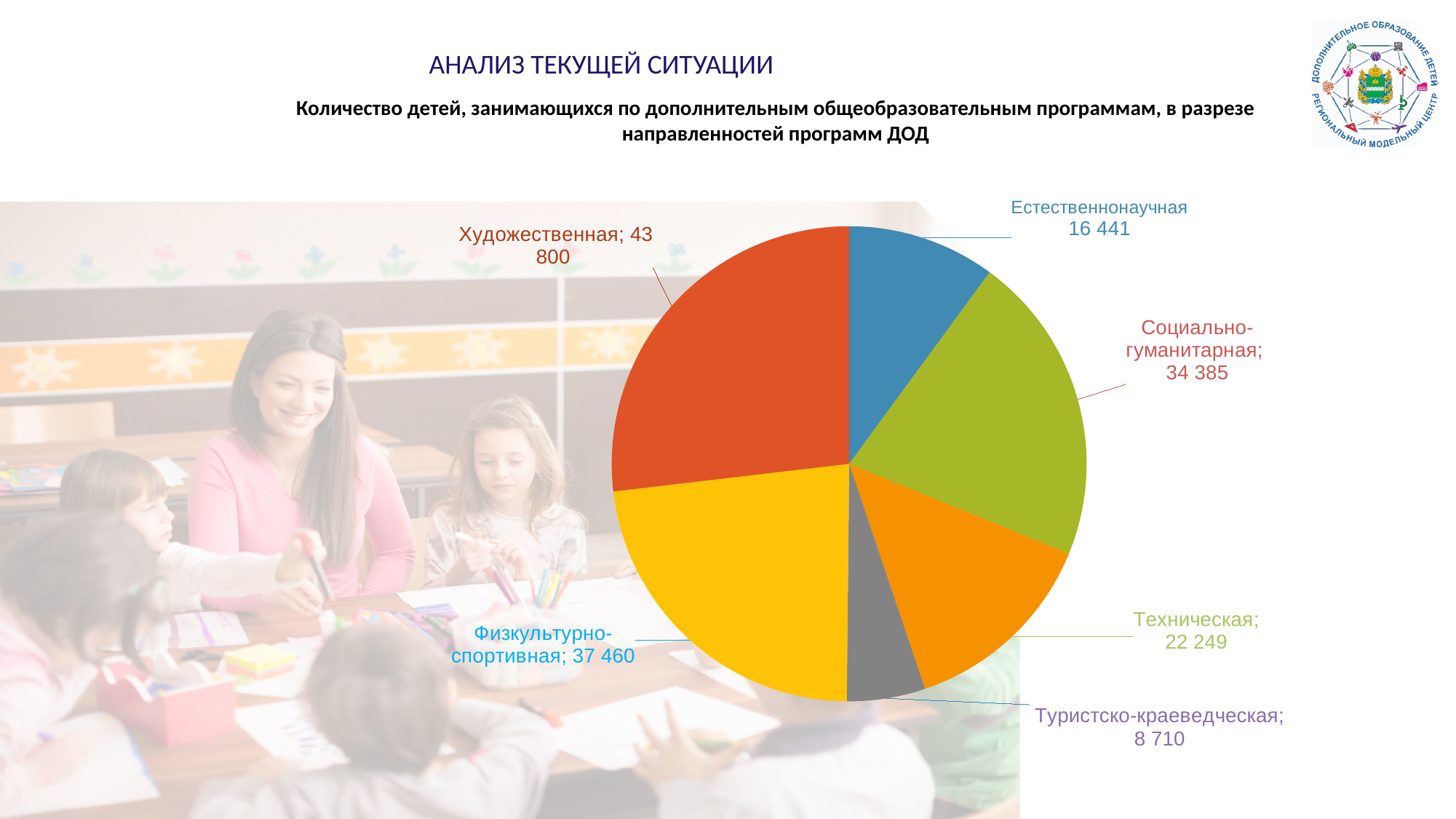
What is the value for Техническая? 22 249 What is the total of all six categories in the pie chart? 163 045 What is the value for Социально-гуманитарная? 34 385 Which category has the highest value? Художественная How many categories (slices) does the pie chart have? 6 What type of chart is shown on the slide? Pie chart What is the value for Туристско-краеведческая? 8 710 What is the value for Художественная? 43 800 Which category has the lowest value? Туристско-краеведческая What is the difference between Художественная and Физкультурно-спортивная? 6 340 Which is larger, Естественнонаучная or Техническая? Техническая What is the difference between Социально-гуманитарная and Техническая? 12 136